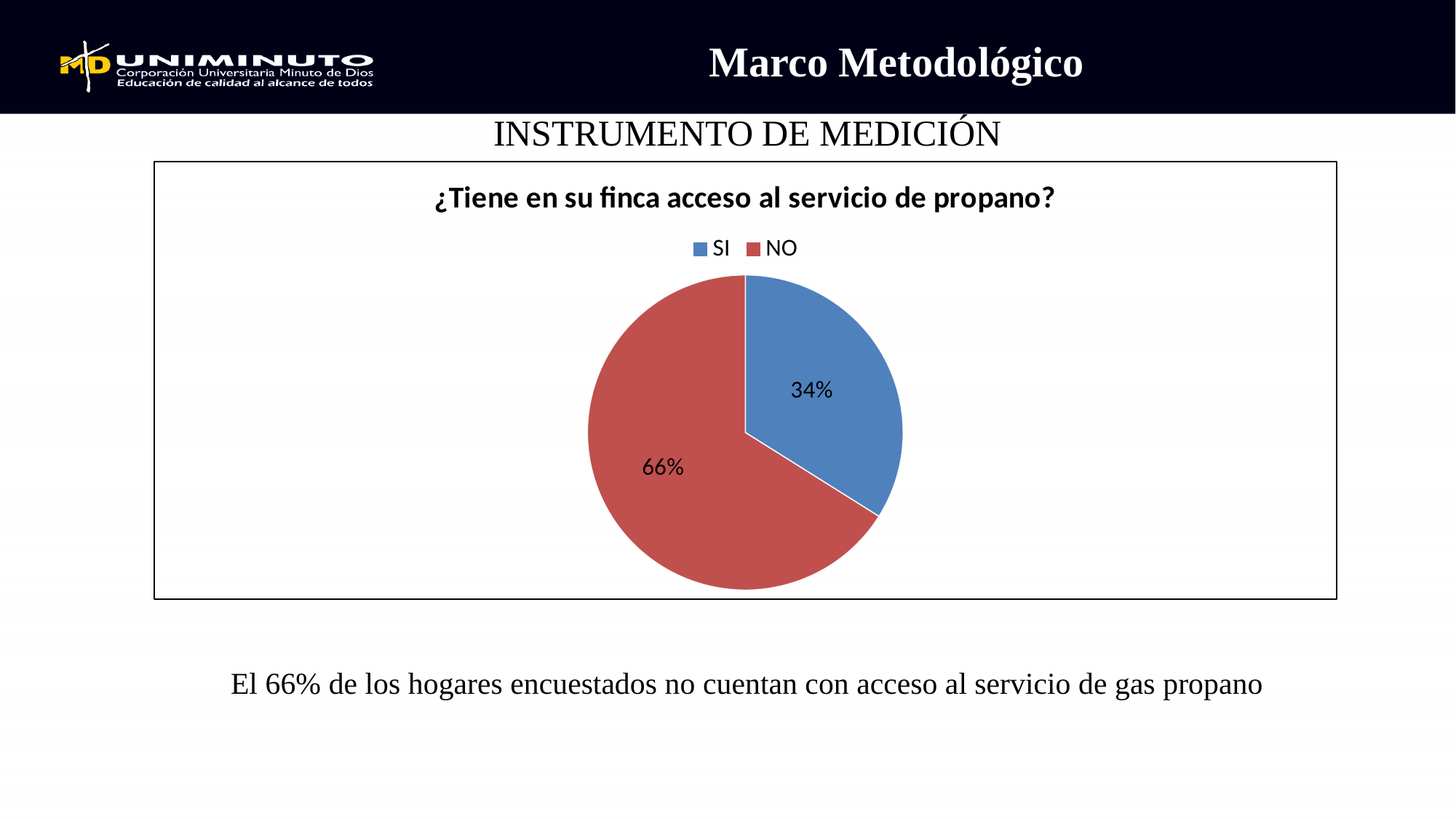
Which category has the smallest share of the pie? SI What is the title of the chart? ¿Tiene en su finca acceso al servicio de propano? What percentage of the pie corresponds to SI? 34% Which category has the largest share of the pie? NO What percentage of the pie corresponds to NO? 66% How many categories does the legend list? 2 What colour is the NO slice? red What is the difference in percentage points between the NO and SI slices? 32 What share of the pie does the SI slice represent? 34% How many slices does the pie chart have? 2 What kind of chart is shown on the slide? pie chart Which slice is larger, SI or NO? NO